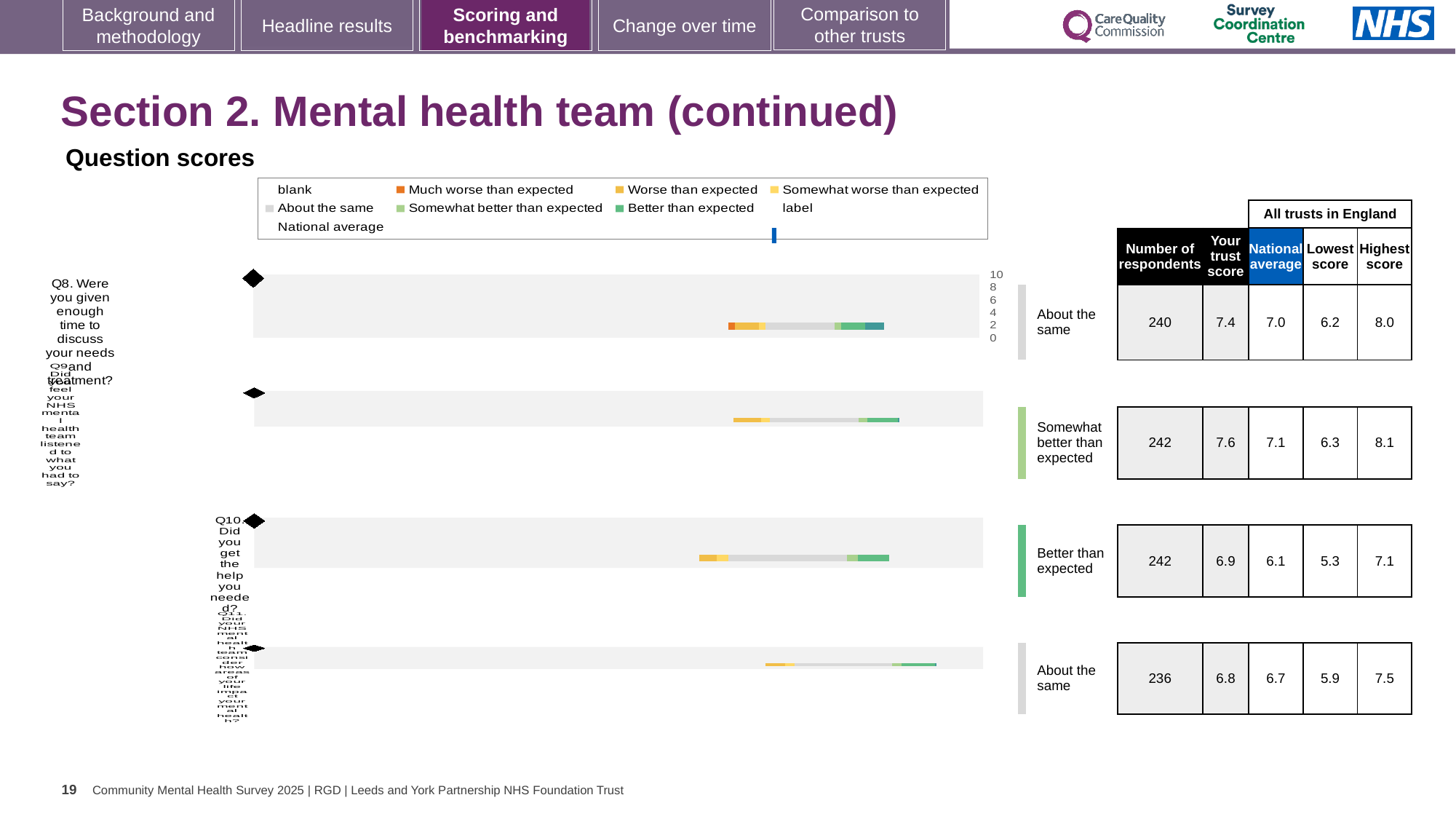
For the Q8 chart, what is the difference between the trust score and the national average? 0.4 For the Q9 chart, what is the national average shown in the accompanying table? 7.1 For the Q8 chart, what is the trust score shown in the accompanying table? 7.4 For the Q11 chart, what is the highest score among all trusts in England? 7.5 For the Q10 chart, what is the number of respondents shown in the accompanying table? 242 For the Q10 chart, which is larger: the trust score or the national average? Trust score How many question charts (Q8 to Q11) are shown on the slide? 4 What type of chart is used to show the question scores for Q8 to Q11? Bar chart What is the maximum value shown on the score axis of the question charts? 10 Which question chart (Q8 to Q11) has the highest trust score? Q9 Which question chart (Q8 to Q11) has the lowest trust score? Q11